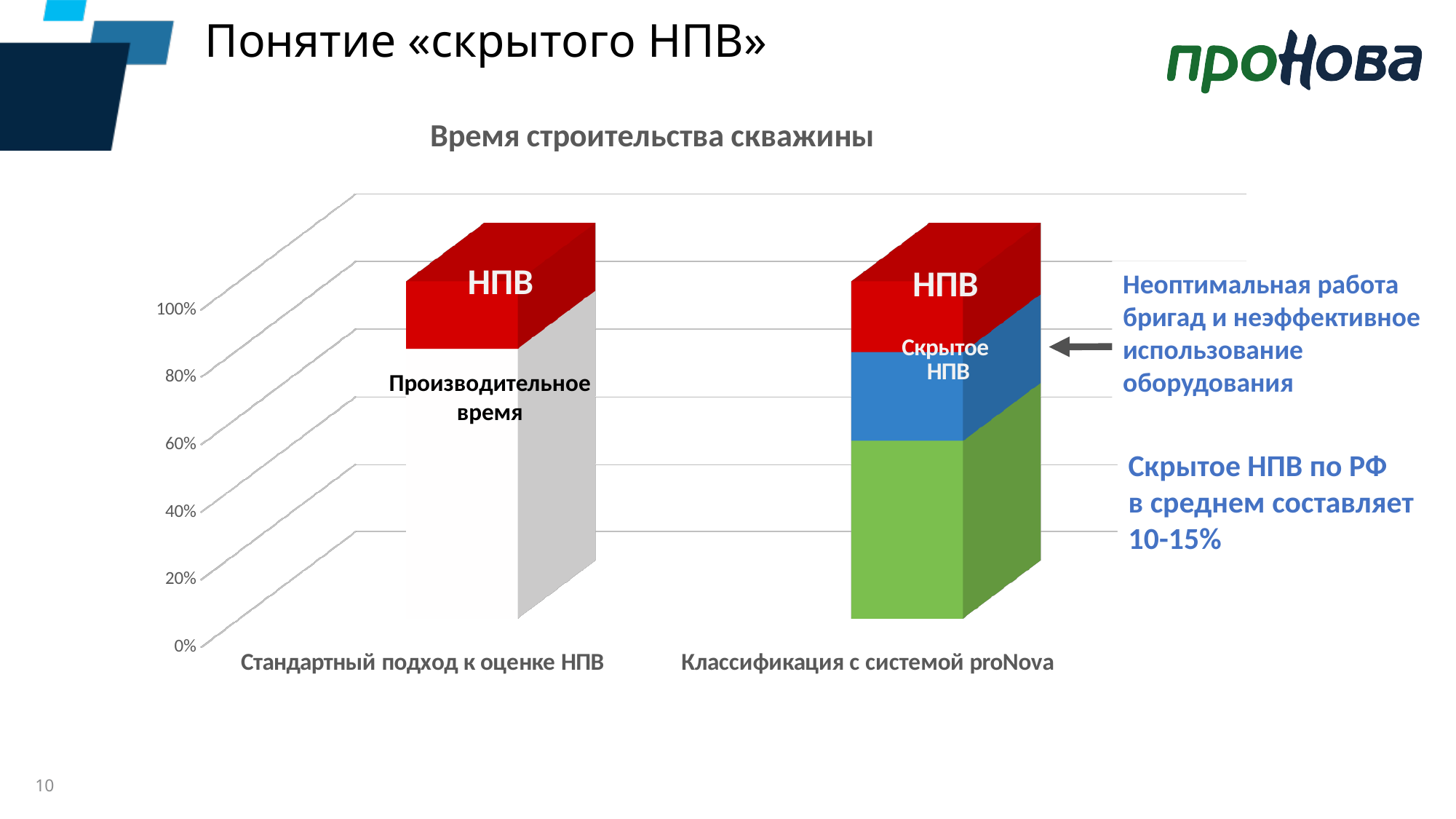
How many categories (bars) are shown on the x axis of the chart? 2 How many segments make up the bar for "Стандартный подход к оценке НПВ"? 2 Which segment is labelled in blue in the "Классификация с системой proNova" bar? Скрытое НПВ What is the highest value shown on the vertical axis of the chart? 100% What kind of chart is shown on the slide? Stacked bar chart How many segments make up the bar for "Классификация с системой proNova"? 3 What is the label of the lower (white) segment in the "Стандартный подход к оценке НПВ" bar? Производительное время What is the title of the chart? Время строительства скважины Which segment sits at the top of both bars in the chart? НПВ What is the label of the left bar on the chart? Стандартный подход к оценке НПВ